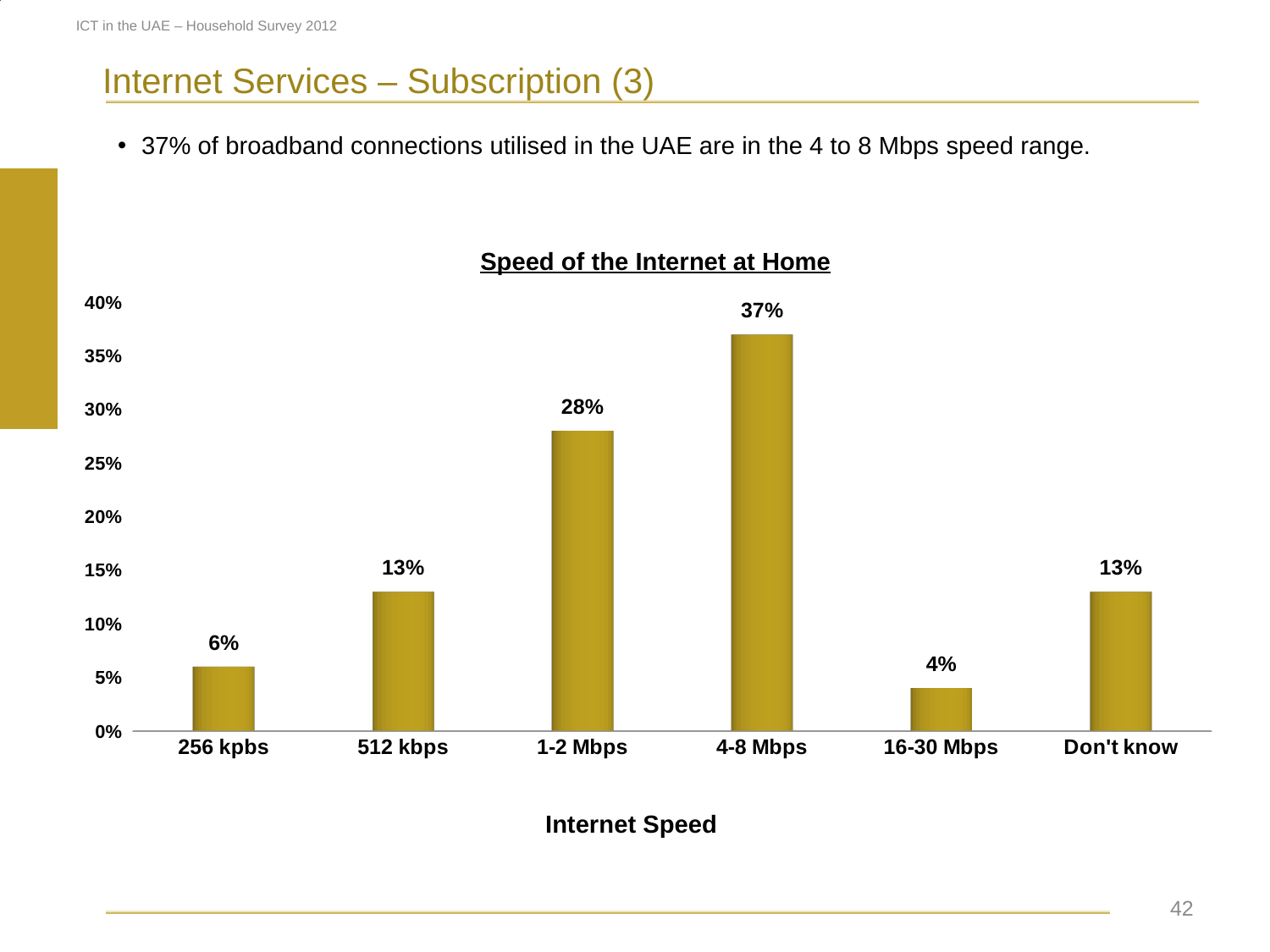
Which internet speed category has the highest value? 4-8 Mbps What is the value for 256 kpbs? 6% What is the title of the chart? Speed of the Internet at Home What is the value for 4-8 Mbps? 37% What is the value for Don't know? 13% Which is larger, the value for 1-2 Mbps or the value for 512 kbps? 1-2 Mbps Which internet speed category has the lowest value? 16-30 Mbps What kind of chart is shown on the slide? bar chart Is the value for 1-2 Mbps greater or less than 25%? greater How many categories are shown on the x axis? 6 What is the difference between the values for 4-8 Mbps and 1-2 Mbps? 9% What is the value for 16-30 Mbps? 4%